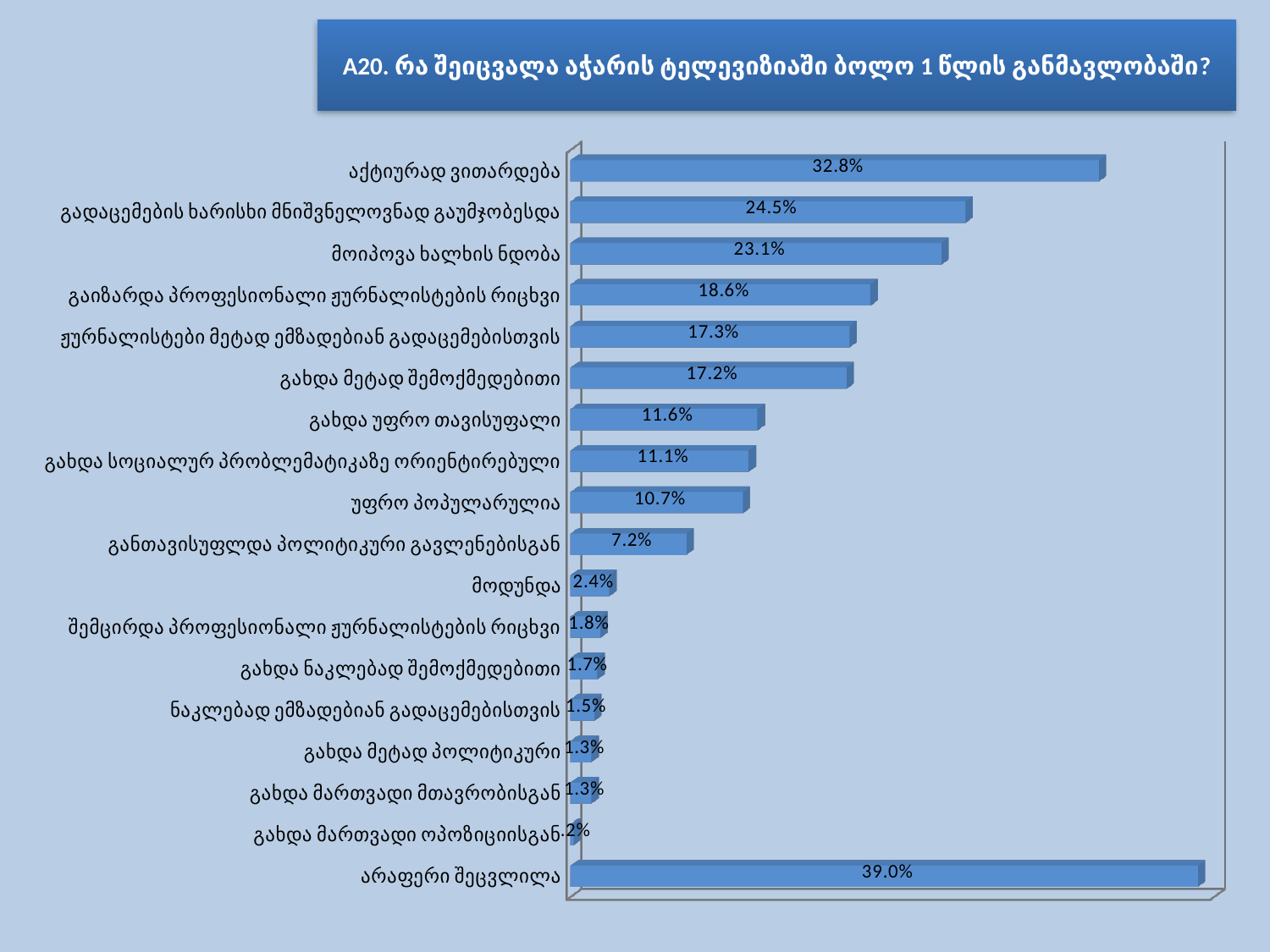
What is the difference between the values for "არაფერი შეცვლილა" and "აქტიურად ვითარდება"? 6.2% What is the value for "აქტიურად ვითარდება"? 32.8% What is the value for "განთავისუფლდა პოლიტიკური გავლენებისგან"? 7.2% What type of chart is shown on the slide? bar chart What is the title of the chart? A20. რა შეიცვალა აჭარის ტელევიზიაში ბოლო 1 წლის განმავლობაში? What is the value for "მოდუნდა"? 2.4% Which category has the lowest value? გახდა მართვადი ოპოზიციისგან Which category has the highest value? არაფერი შეცვლილა Which is larger: the value for "გადაცემების ხარისხი მნიშვნელოვნად გაუმჯობესდა" or the value for "გაიზარდა პროფესიონალი ჟურნალისტების რიცხვი"? გადაცემების ხარისხი მნიშვნელოვნად გაუმჯობესდა What is the value for "მოიპოვა ხალხის ნდობა"? 23.1% How many categories are shown in the chart? 18 What is the value for "არაფერი შეცვლილა"? 39.0%